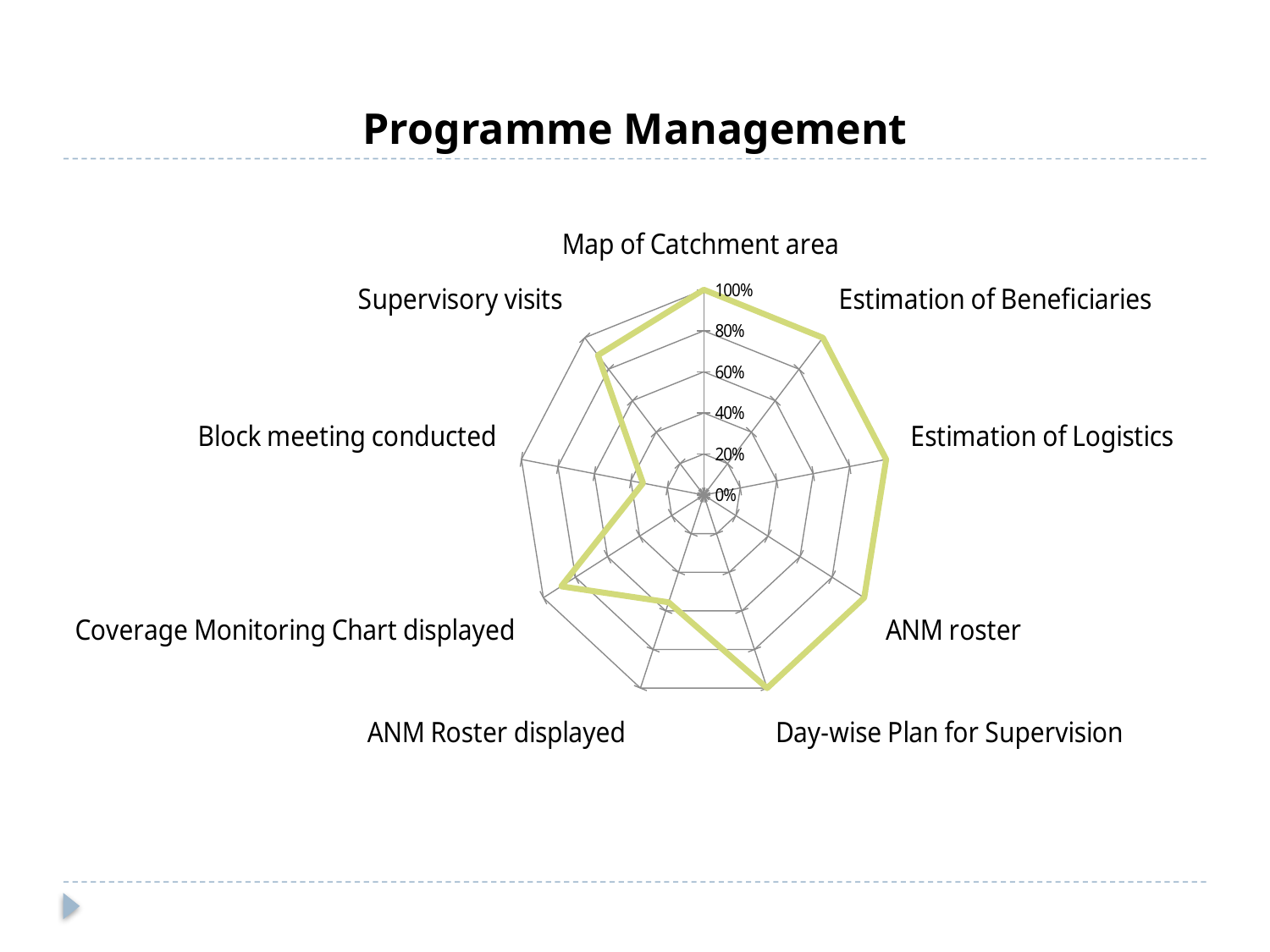
What is the maximum value shown on the chart's axis scale? 100% What is the value for Map of Catchment area? 100% Is the value for ANM roster greater or less than 80%? greater What is the title of the chart on the slide? Programme Management Is the value for Coverage Monitoring Chart displayed greater or less than 60%? greater Is the value for Day-wise Plan for Supervision greater or less than 80%? greater Which is larger, the value for Estimation of Logistics or the value for Block meeting conducted? Estimation of Logistics What kind of chart is shown on the slide? Radar chart Which category has the lowest value on the chart? Block meeting conducted How many categories (axes) does the radar chart have? 9